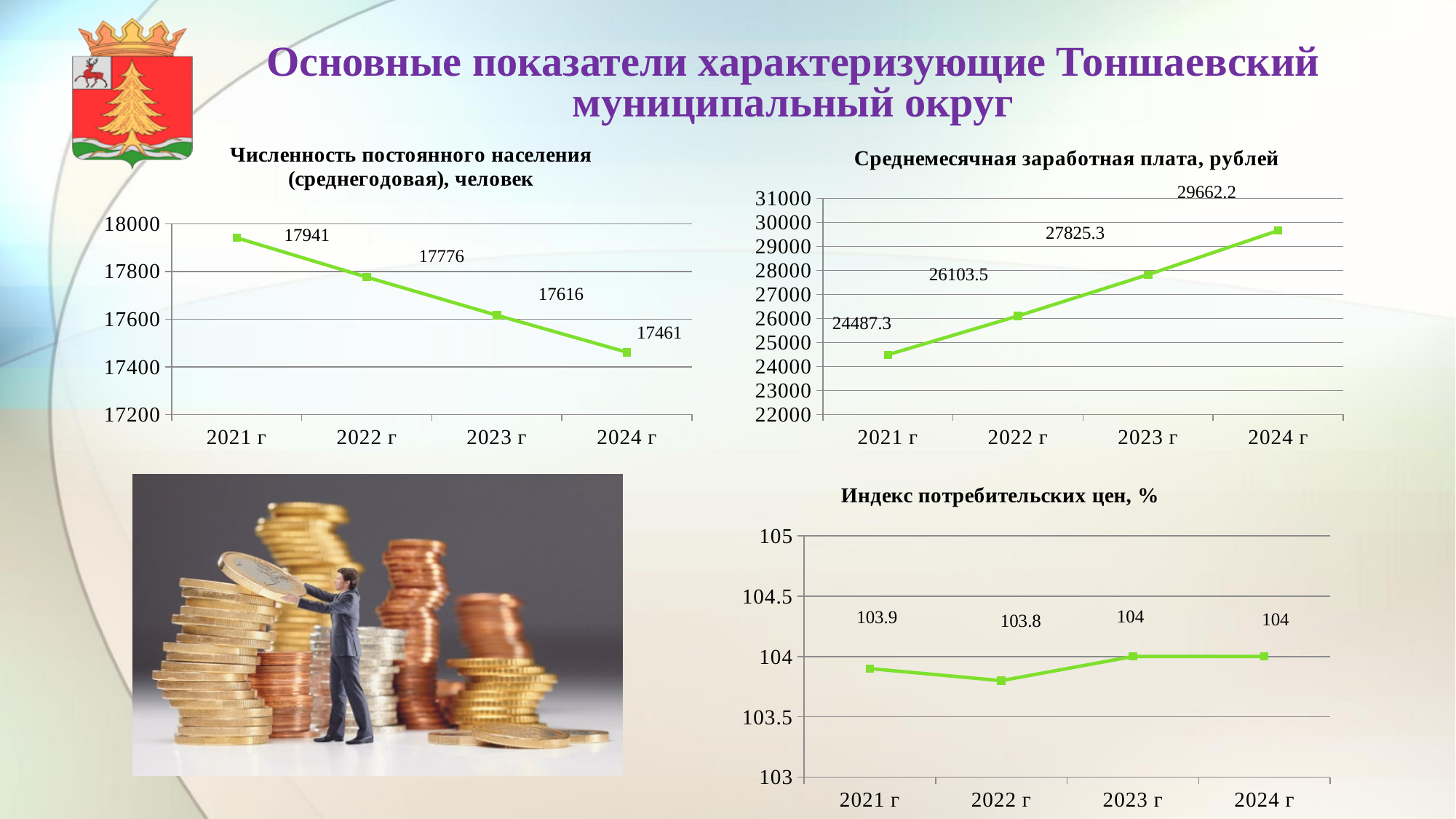
In the chart 'Индекс потребительских цен, %', which is larger, the value for 2021 г or the value for 2022 г? 2021 г In the chart 'Численность постоянного населения (среднегодовая), человек', do the values rise or fall from 2021 г to 2024 г? fall In the chart 'Среднемесячная заработная плата, рублей', what is the value for 2023 г? 27825.3 In the chart 'Индекс потребительских цен, %', what is the value for 2022 г? 103.8 In the chart 'Среднемесячная заработная плата, рублей', what is the difference between the 2022 г and 2021 г values? 1616.2 In the chart 'Численность постоянного населения (среднегодовая), человек', which year has the lowest value? 2024 г In the chart 'Численность постоянного населения (среднегодовая), человек', what is the difference between the 2021 г and 2024 г values? 480 In the chart 'Среднемесячная заработная плата, рублей', how many data points are plotted? 4 In the chart 'Численность постоянного населения (среднегодовая), человек', what is the value for 2021 г? 17941 In the chart 'Среднемесячная заработная плата, рублей', which year has the highest value? 2024 г What kind of chart is 'Индекс потребительских цен, %'? line chart How many charts are shown on the slide? 3